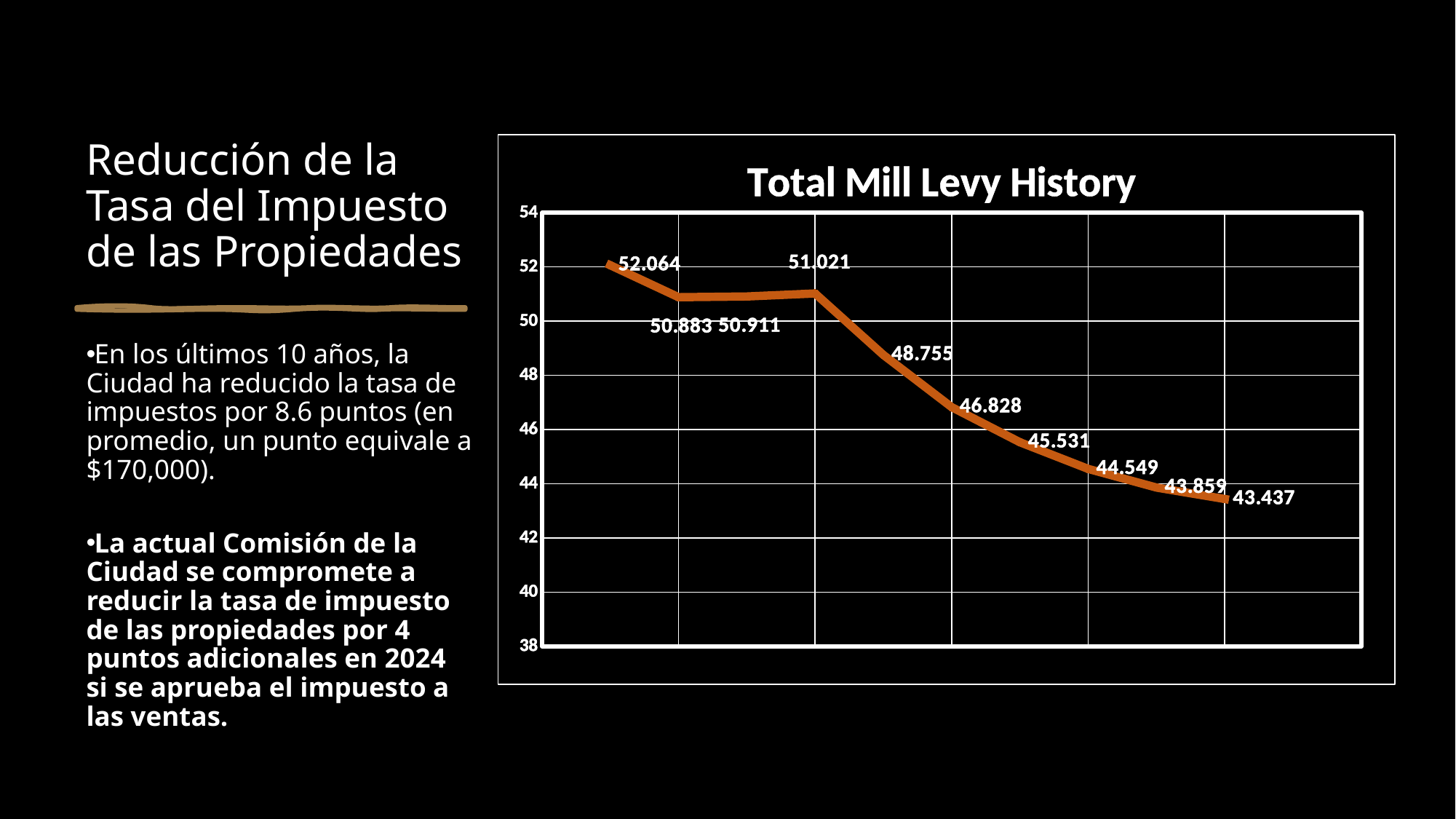
What is the highest value labelled on the Total Mill Levy History chart? 52.064 What is the lowest value labelled on the Total Mill Levy History chart? 43.437 Is the value of the last point on the Total Mill Levy History line greater or less than 44? less What is the value of the first (leftmost) point on the Total Mill Levy History line? 52.064 What are the minimum and maximum values shown on the vertical axis of the Total Mill Levy History chart? 38 and 54 What kind of chart is shown on the slide? line chart How many data points are plotted on the line in the Total Mill Levy History chart? 10 What is the value of the last (rightmost) point on the Total Mill Levy History line? 43.437 What is the title of the chart? Total Mill Levy History Overall, do the values in the Total Mill Levy History chart rise or fall from left to right? fall What is the difference between the first point (52.064) and the last point (43.437) on the Total Mill Levy History chart? 8.627 Which is larger on the Total Mill Levy History chart: the point labelled 48.755 or the point labelled 46.828? 48.755